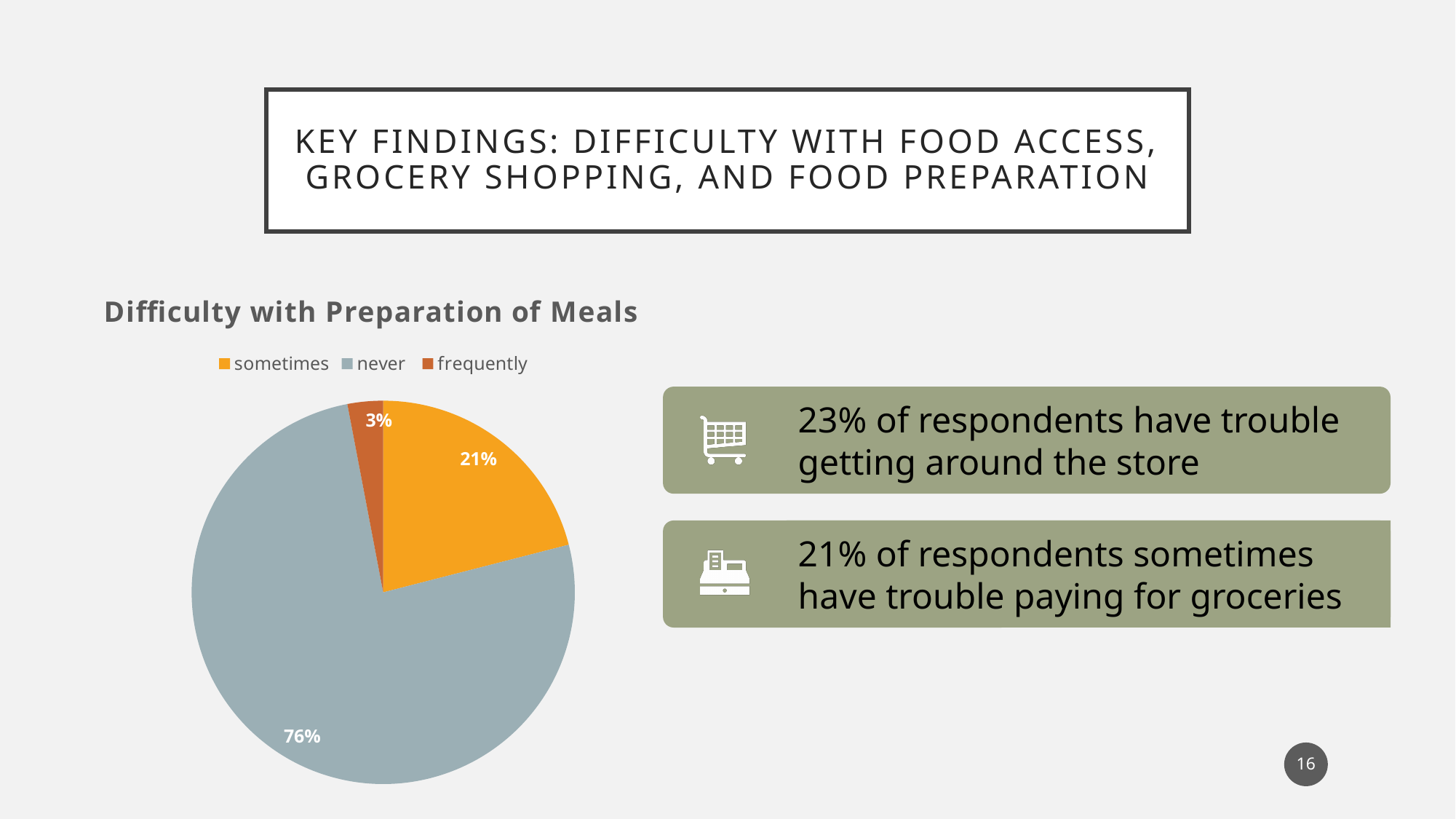
How many entries does the legend list? 3 Which category has the smallest slice of the pie? frequently What type of chart is shown on the slide? pie chart Which slice is larger, "sometimes" or "frequently"? sometimes How many categories does the pie chart show? 3 Which category has the largest slice of the pie? never What is the difference in percentage points between the "never" and "sometimes" slices? 55 What share of the pie is labelled "frequently"? 3% What colour is the "never" slice in the pie chart? grey-blue What is the title of the chart? Difficulty with Preparation of Meals What share of the pie is labelled "never"? 76% What share of the pie is labelled "sometimes"? 21%